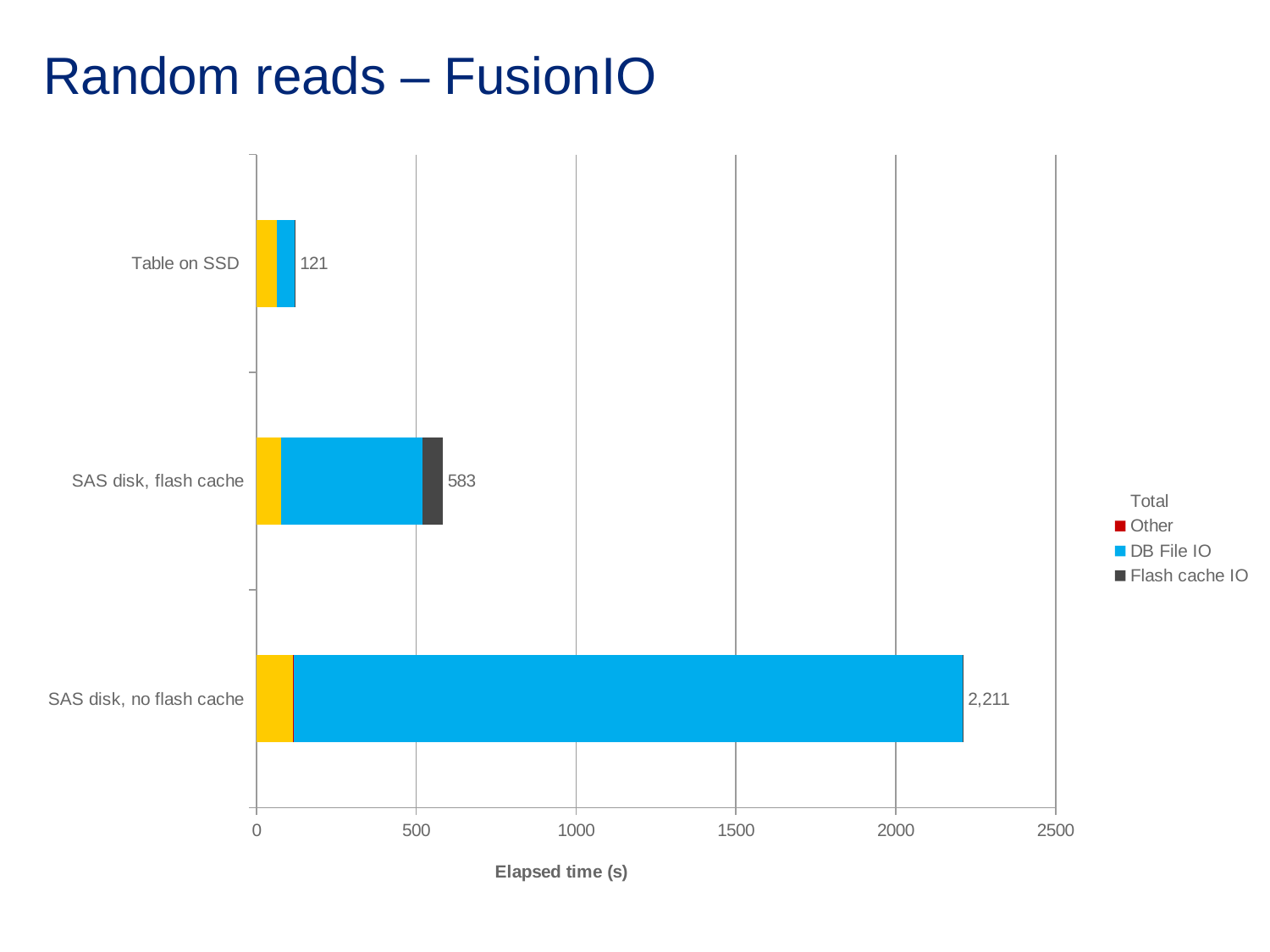
What is the difference in total elapsed time between "SAS disk, flash cache" and "Table on SSD"? 462 Is the total for "SAS disk, no flash cache" greater or less than 2000? greater What is the total elapsed time labelled for the "Table on SSD" bar? 121 Which has a larger total elapsed time, "SAS disk, flash cache" or "Table on SSD"? SAS disk, flash cache What is the total elapsed time labelled for the "SAS disk, flash cache" bar? 583 Which category has the lowest total elapsed time? Table on SSD What kind of chart is shown on the slide? Stacked bar chart Which category has the highest total elapsed time? SAS disk, no flash cache How many categories are shown on the chart? 3 What is the label of the horizontal axis? Elapsed time (s) What is the total elapsed time labelled for the "SAS disk, no flash cache" bar? 2,211 What is the difference in total elapsed time between "SAS disk, no flash cache" and "SAS disk, flash cache"? 1,628